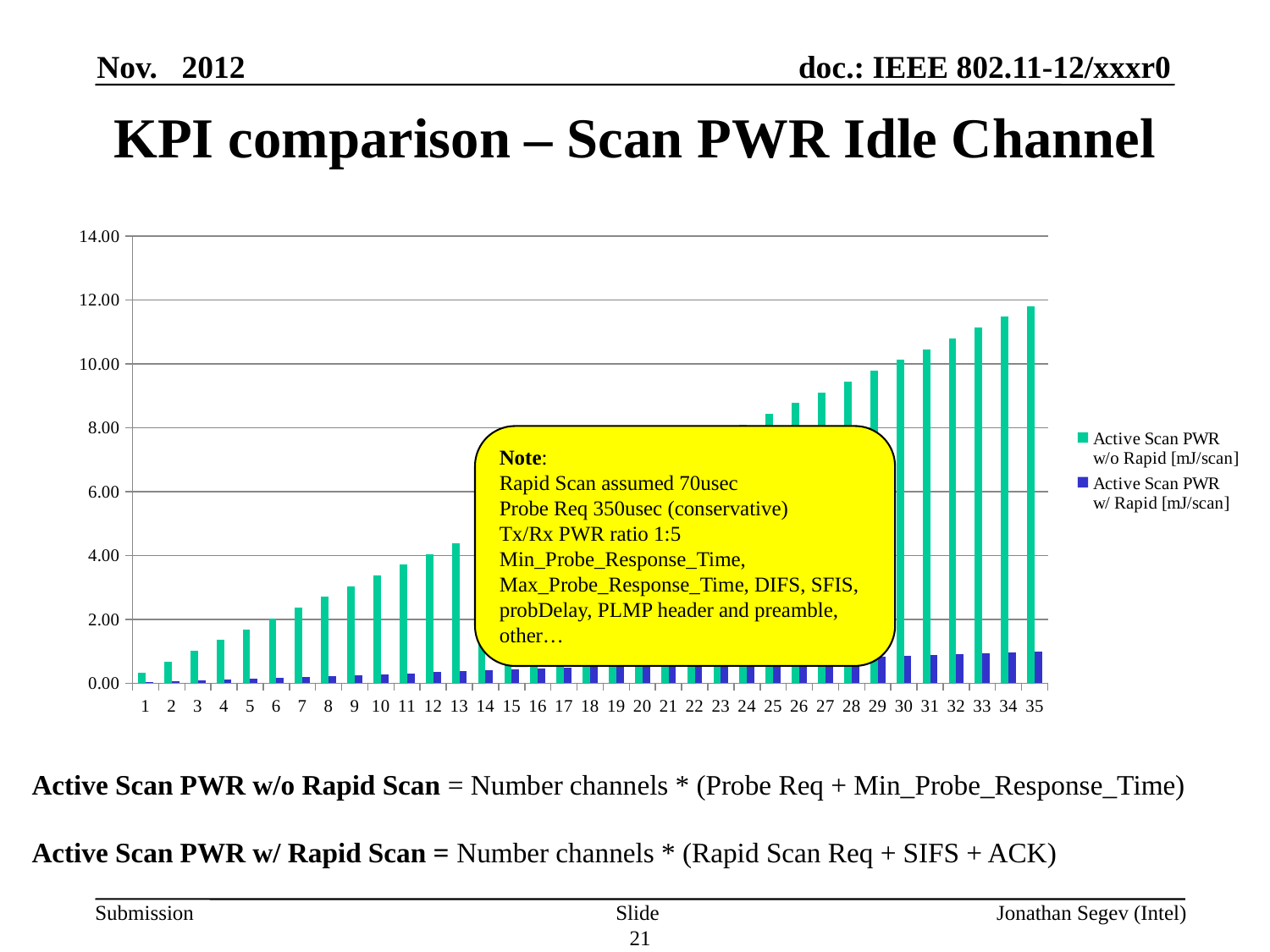
At category 35, which series has the larger value: Active Scan PWR w/o Rapid or Active Scan PWR w/ Rapid? Active Scan PWR w/o Rapid [mJ/scan] Do the values for Active Scan PWR w/o Rapid [mJ/scan] rise or fall as the category number increases along the x axis? rise Which category has the lowest value for Active Scan PWR w/o Rapid [mJ/scan]? 1 Is the value for Active Scan PWR w/o Rapid [mJ/scan] at category 5 greater or less than 2.00? less Is the value for Active Scan PWR w/o Rapid [mJ/scan] at category 10 greater or less than 2.00? greater How many categories are shown along the x axis of the chart? 35 Which category has the highest value for Active Scan PWR w/o Rapid [mJ/scan]? 35 How many series does the chart legend list? 2 What are the two series names listed in the chart legend? Active Scan PWR w/o Rapid [mJ/scan] and Active Scan PWR w/ Rapid [mJ/scan] What kind of chart is shown on the slide? bar chart Is the value for Active Scan PWR w/ Rapid [mJ/scan] at category 35 greater or less than 2.00? less